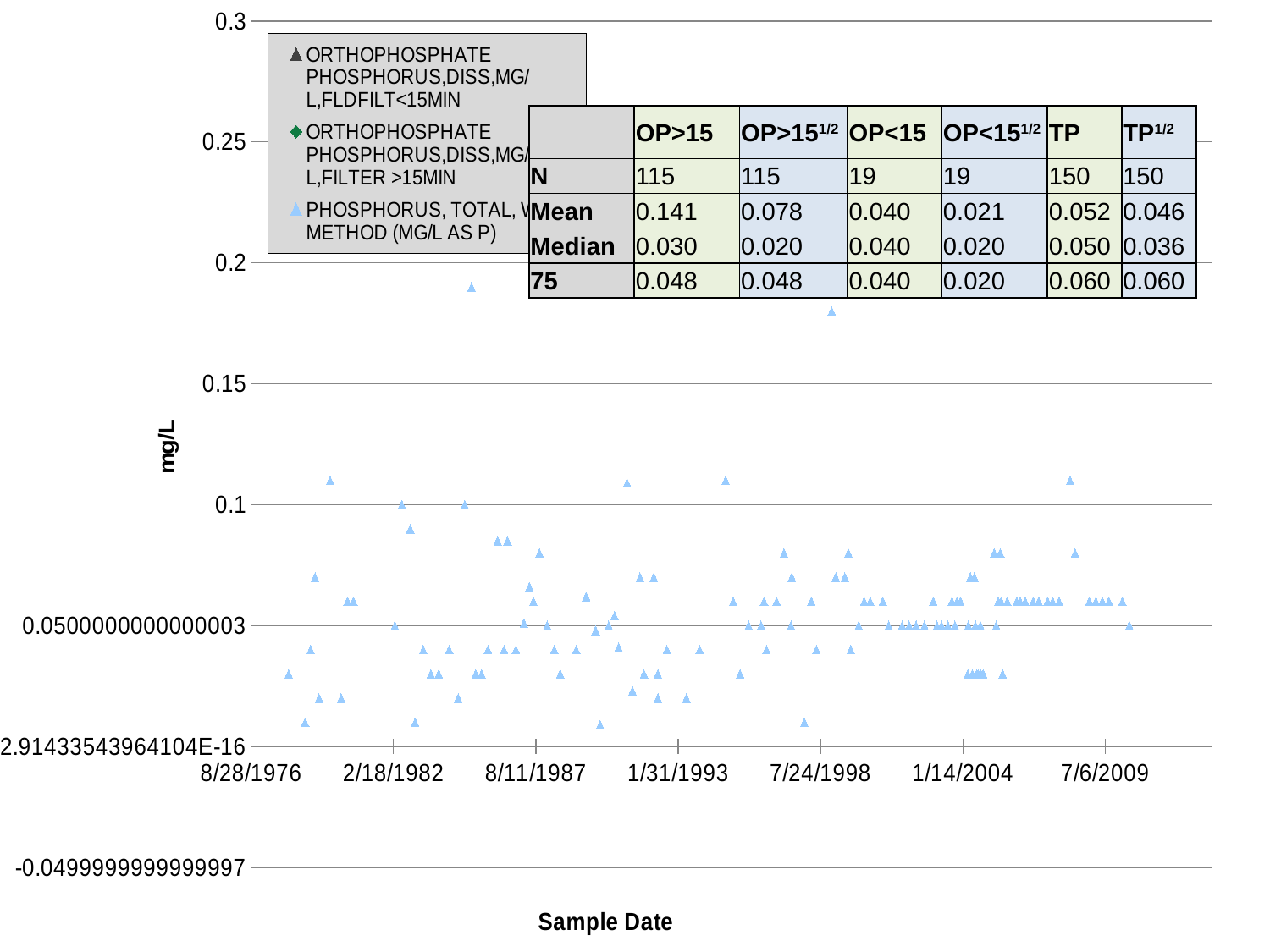
Is the highest plotted point on the chart greater or less than 0.2 mg/L? less How many series does the chart's legend list? 3 What is the title of the chart's vertical axis? mg/L What is the title of the chart's horizontal axis? Sample Date Is the highest plotted point on the chart greater or less than 0.15 mg/L? greater What kind of chart is shown on the slide? scatter chart